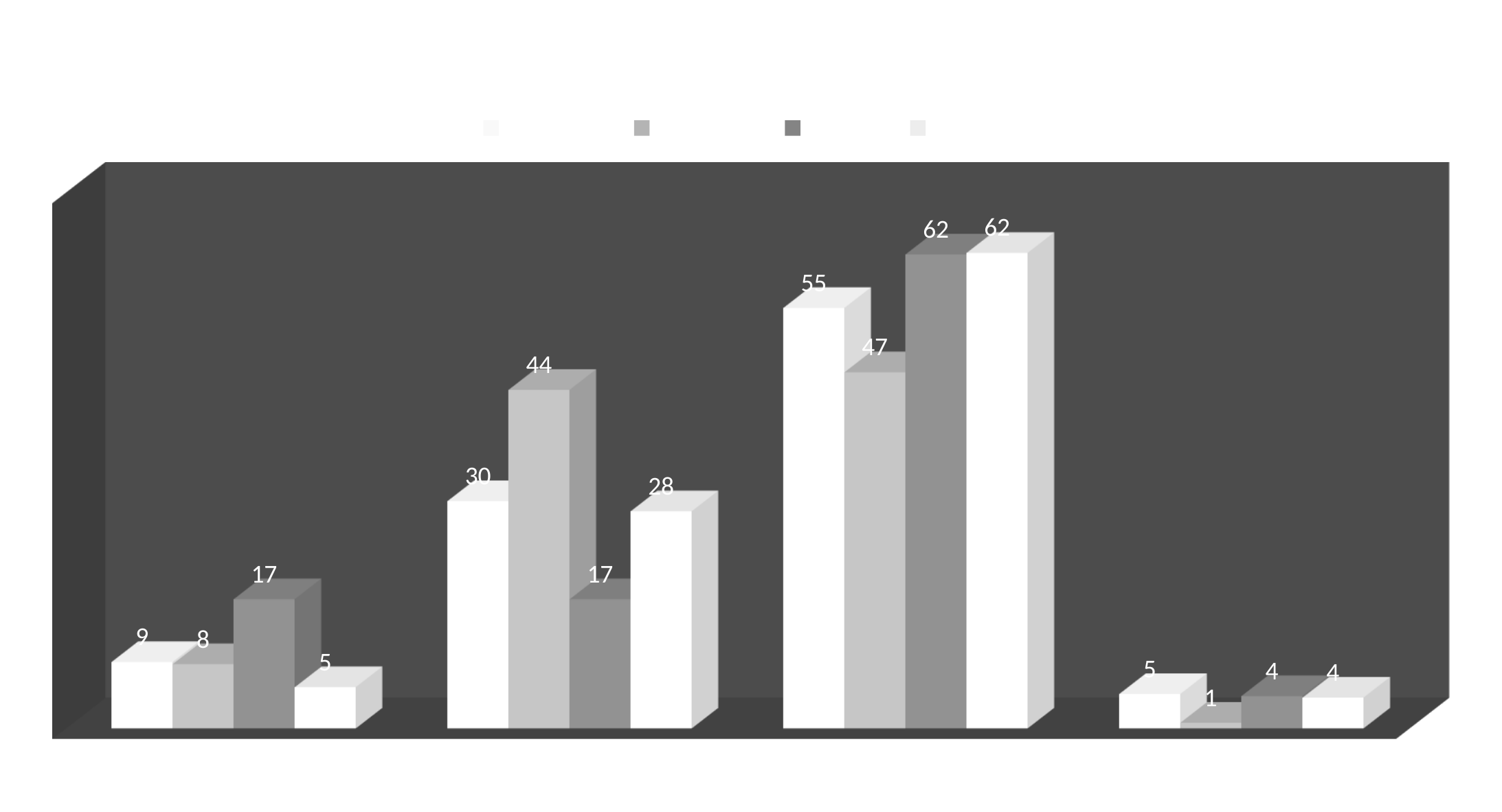
What is the lowest data label value shown on the chart? 1 What is the value of the second bar in the rightmost group? 1 What is the highest data label value shown on the chart? 62 What is the value of the tallest bar in the second group from the left? 44 What is the value of the first (leftmost) bar in the leftmost group? 9 What kind of chart is shown on the slide? bar chart In the second group from the left, what is the difference between the second bar (44) and the first bar (30)? 14 Which group of bars has the highest values overall: the first, second, third or fourth from the left? the third What is the total of the four bars in the third group from the left? 226 In the leftmost group, which is larger: the first bar or the third bar? the third bar How many groups of bars are plotted along the x axis? 4 How many series does the legend list? 4